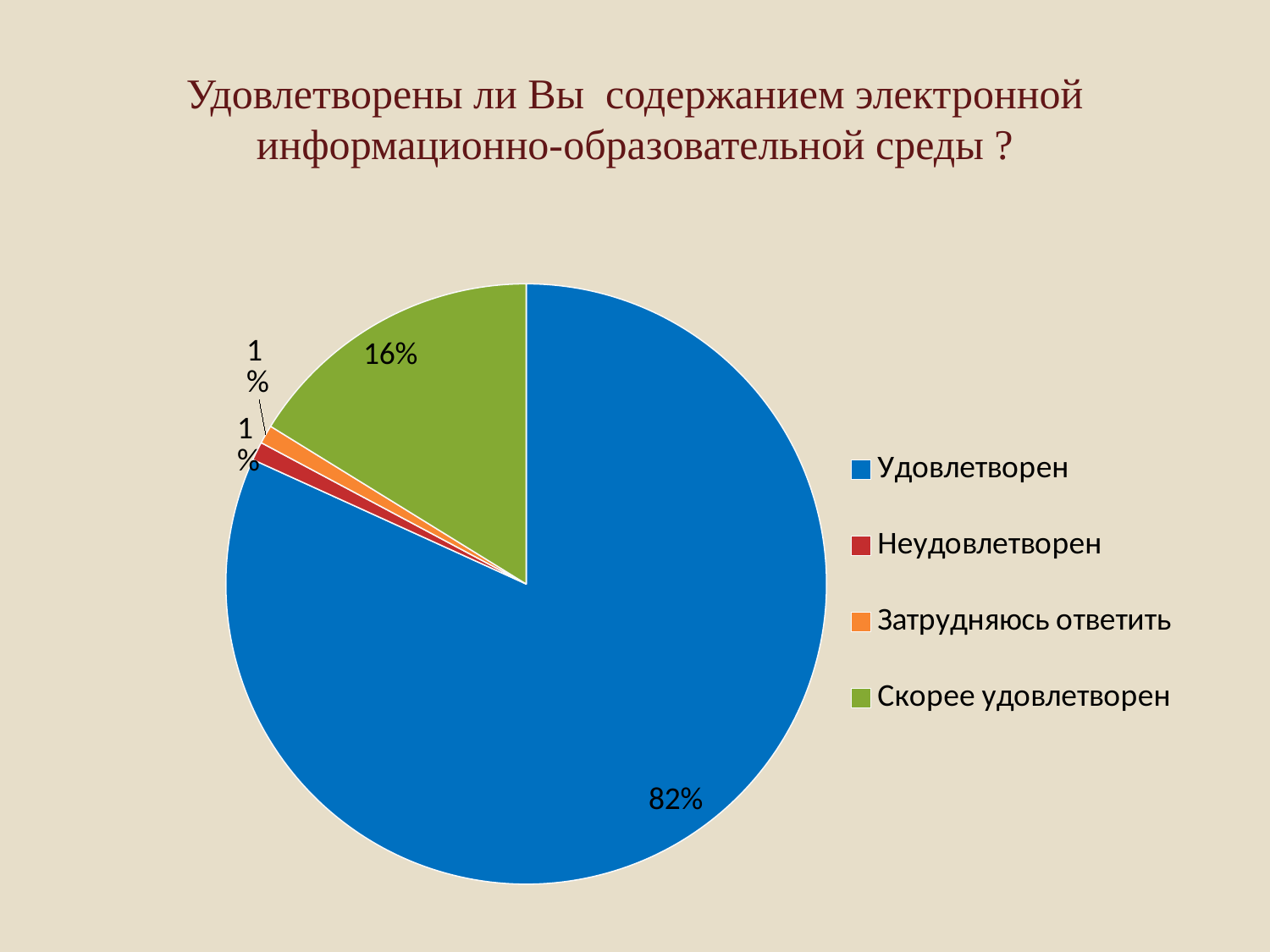
What share of the pie does Затрудняюсь ответить take? 1% What is the title of the chart? Удовлетворены ли Вы содержанием электронной информационно-образовательной среды ? What is the combined share of Удовлетворен and Скорее удовлетворен? 98% What is the difference between the shares for Удовлетворен and Скорее удовлетворен? 66% How many slices does the pie chart have? 4 What kind of chart is shown on the slide? pie chart Which category has the largest slice of the pie? Удовлетворен What share of the pie does Неудовлетворен take? 1% What colour is the slice for Скорее удовлетворен? green What share of the pie does Удовлетворен take? 82% Which is larger, the share for Скорее удовлетворен or the share for Неудовлетворен? Скорее удовлетворен